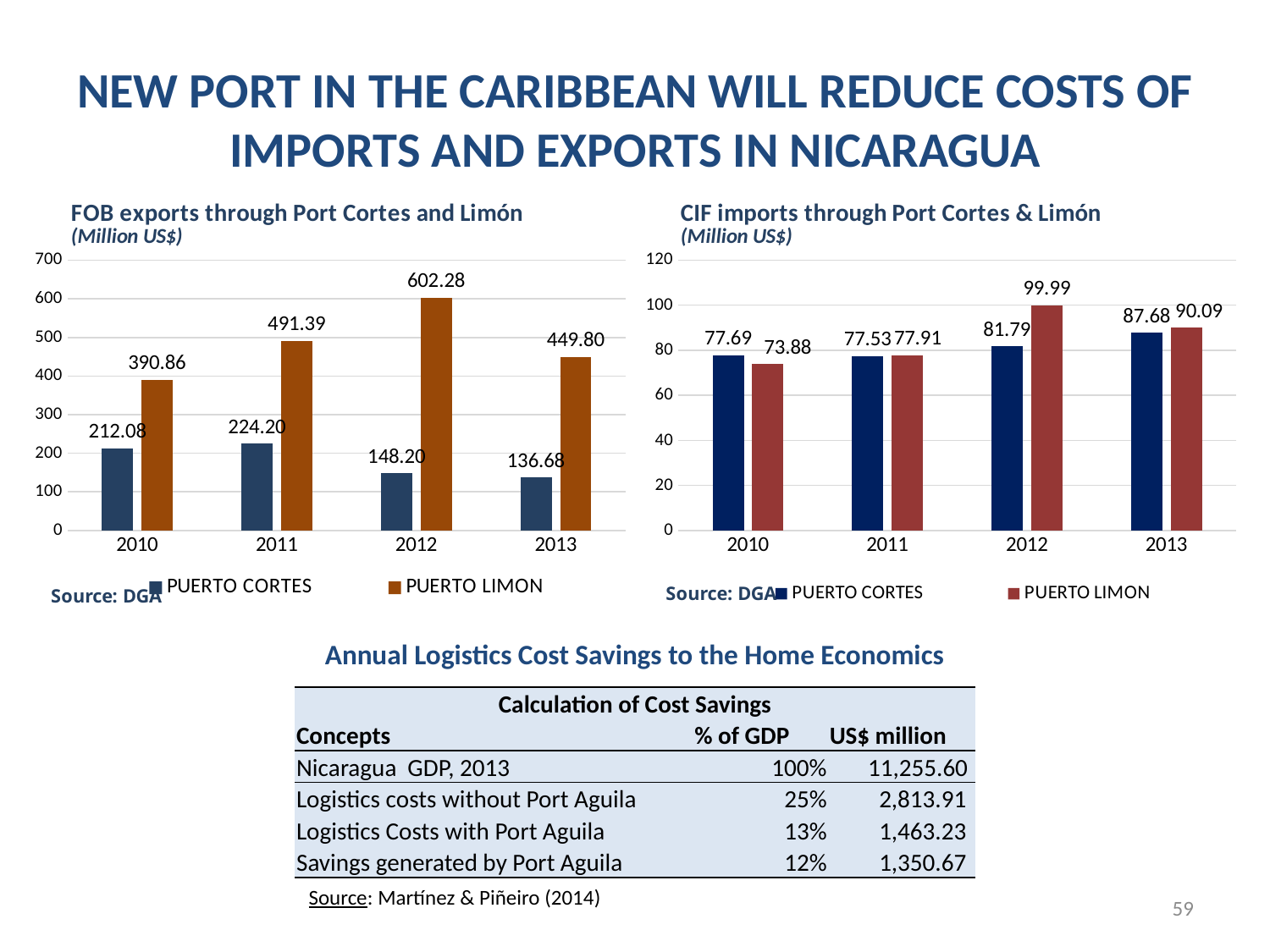
In the FOB exports chart, what is the difference between PUERTO LIMON and PUERTO CORTES in 2011? 267.19 In the CIF imports chart, what is the value for PUERTO LIMON in 2012? 99.99 In the FOB exports chart, what is the value for PUERTO LIMON in 2012? 602.28 In the FOB exports chart, how many series does the legend list? 2 In the CIF imports chart, how many years are shown on the x axis? 4 In the CIF imports chart, which is larger in 2010, PUERTO CORTES or PUERTO LIMON? PUERTO CORTES In the FOB exports chart, which year has the lowest value for PUERTO CORTES? 2013 What kind of chart is the CIF imports chart? Bar chart In the CIF imports chart, what is the value for PUERTO CORTES in 2010? 77.69 In the FOB exports chart, what is the value for PUERTO CORTES in 2013? 136.68 In the FOB exports chart, which year has the highest value for PUERTO LIMON? 2012 In the CIF imports chart, which year has the highest value for PUERTO CORTES? 2013